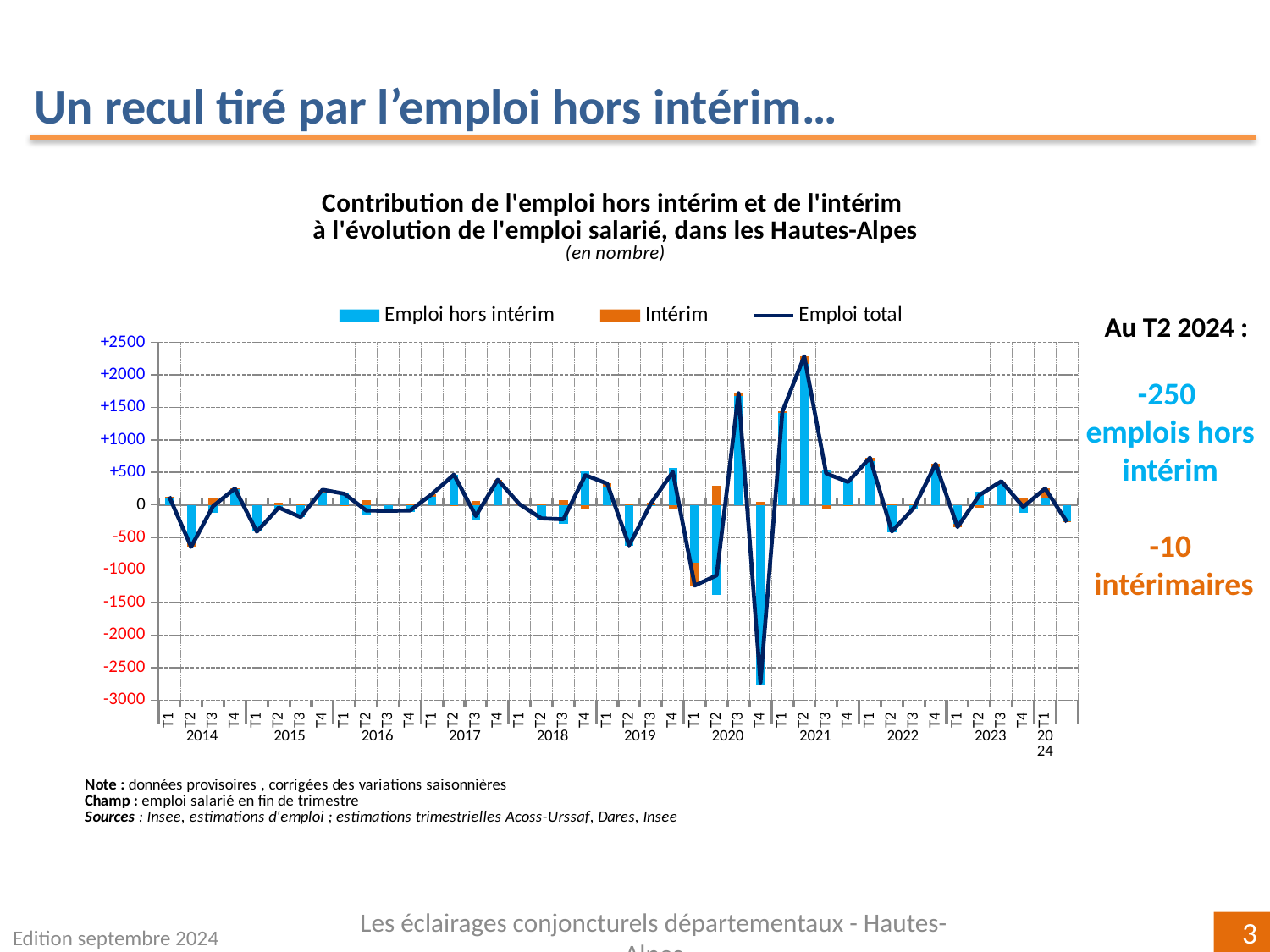
Which is larger, the Emploi total value for T2 2021 or for T3 2020? T2 2021 Which colour represents the Intérim series in the chart? Orange In which quarter does the Emploi total line reach its highest value? T2 2021 In which quarter does the Emploi total line reach its lowest value? T4 2020 According to the slide, what is the value for Intérim at T2 2024? -10 Is the Emploi total value for T2 2021 greater or less than +2000? greater What is the title of the chart? Contribution de l'emploi hors intérim et de l'intérim à l'évolution de l'emploi salarié, dans les Hautes-Alpes Is the Emploi total value for T4 2020 greater or less than -2500? less How many series does the chart legend list? 3 What kind of chart is shown on the slide? A combined bar and line chart According to the slide, what is the value for Emploi hors intérim at T2 2024? -250 Is the Emploi hors intérim value for T1 2021 greater or less than +1000? greater